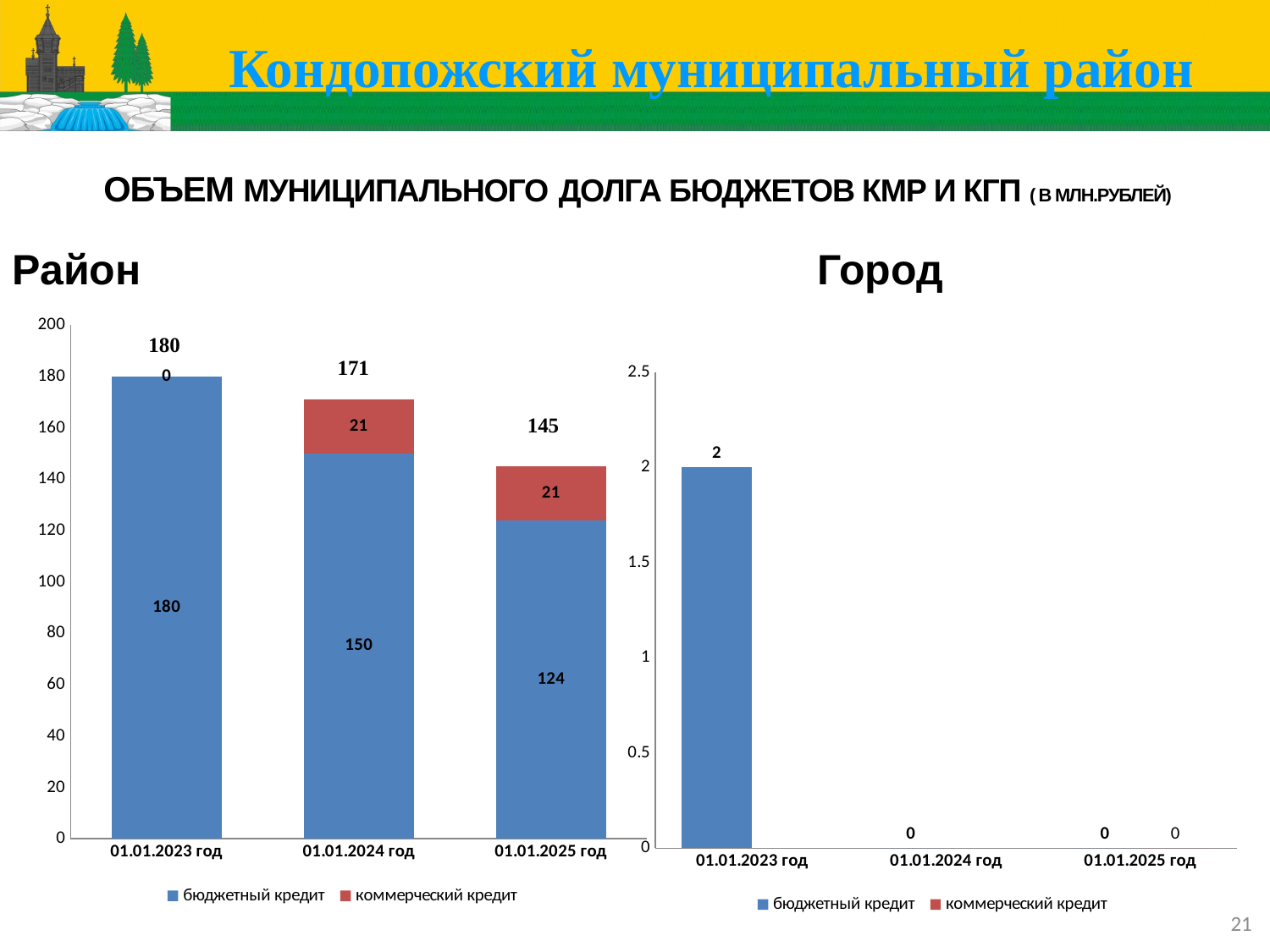
In the "Город" chart, what is the value shown for 01.01.2024 год? 0 In the "Город" chart, what is the value of бюджетный кредит for 01.01.2023 год? 2 In the "Район" chart, what is the value of бюджетный кредит for 01.01.2024 год? 150 In the "Район" chart, what is the total of the stacked bar for 01.01.2025 год? 145 In the "Район" chart, which date has the highest value of бюджетный кредит? 01.01.2023 год In the "Район" chart, what is the total of the stacked bar for 01.01.2024 год? 171 In the "Район" chart, what is the difference between бюджетный кредит on 01.01.2023 год and on 01.01.2025 год? 56 In the "Район" chart, what is the value of коммерческий кредит for 01.01.2025 год? 21 In the "Район" chart, does the value of бюджетный кредит rise or fall from 01.01.2023 год to 01.01.2025 год? fall In the "Район" chart, how many dates are shown on the x axis? 3 What kind of chart is the "Район" chart? stacked bar chart How many series does the legend of the "Город" chart list? 2